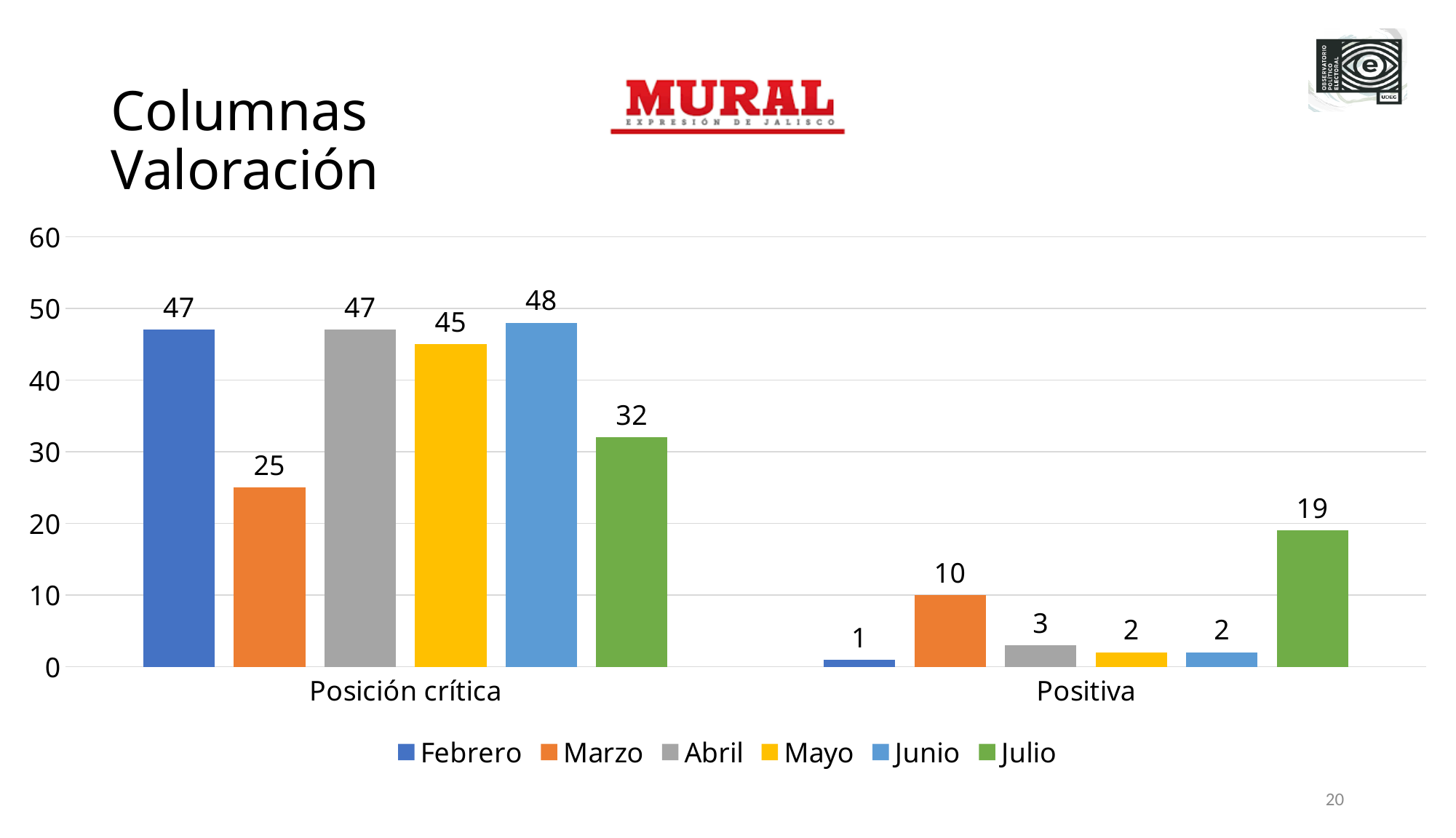
What is the value for Junio in the Posición crítica category? 48 What is the value for Marzo in the Positiva category? 10 How many series does the legend list? 6 What is the difference between the Junio and Marzo values in the Posición crítica category? 23 Which month has the highest value in the Positiva category? Julio What is the value for Julio in the Posición crítica category? 32 Which month has the lowest value in the Posición crítica category? Marzo How many categories are shown on the x axis? 2 Which colour represents Mayo in the legend? Yellow Which is larger in the Positiva category: Marzo or Abril? Marzo What is the difference between the Julio values for Posición crítica and Positiva? 13 What kind of chart is shown on the slide? Bar chart